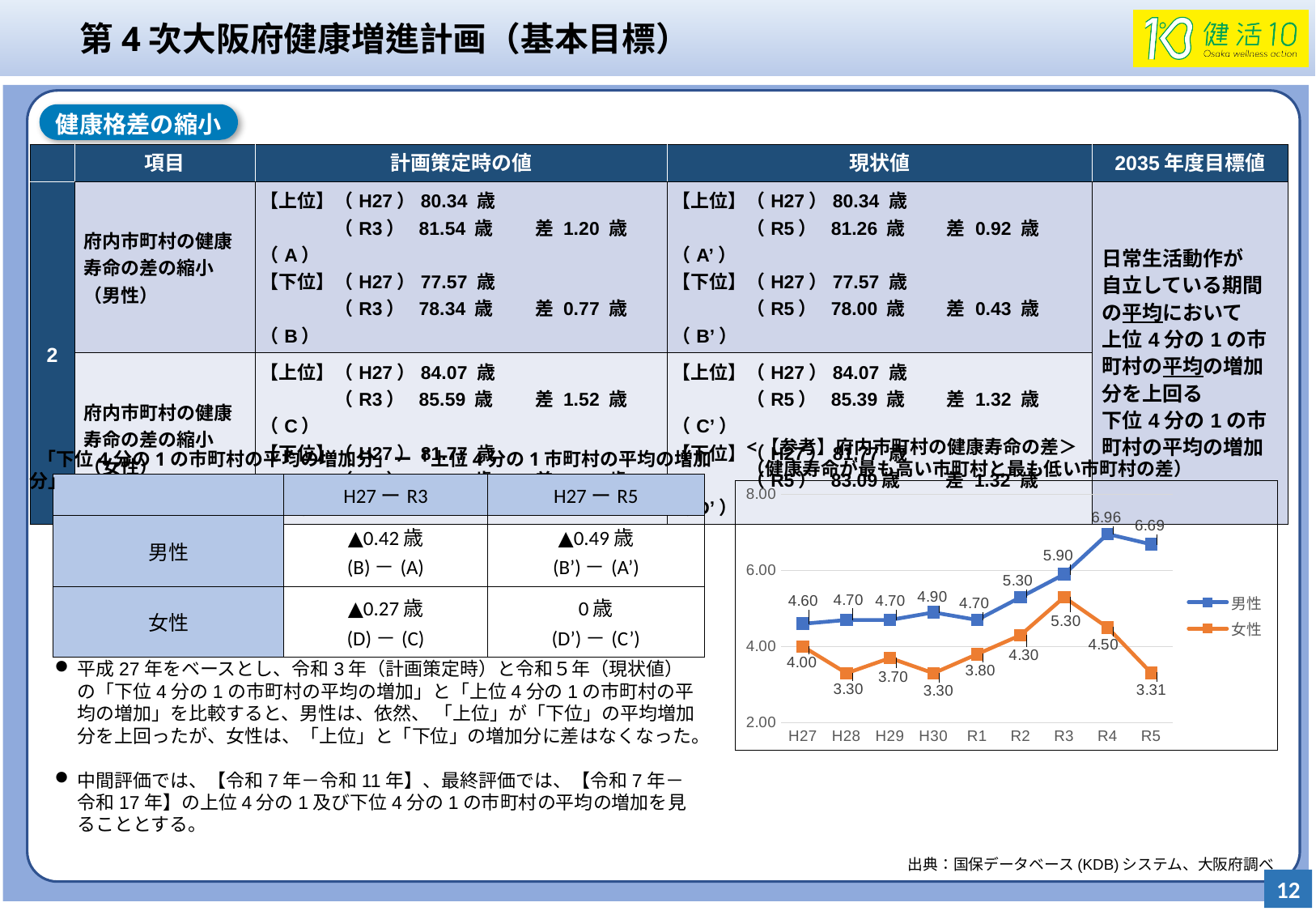
In the line chart, what is the value for 男性 at R4? 6.96 Which series in the line chart is drawn in orange? 女性 In the line chart, at which x-axis point is the 男性 series highest? R4 In the line chart, what is the value for 女性 at R5? 3.31 In the line chart, what is the value for 男性 at H27? 4.60 What kind of chart is shown on the slide? line chart How many series does the legend of the line chart list? 2 In the line chart, what is the difference between the 男性 and 女性 values at R5? 3.38 In the line chart, at which x-axis point is the 女性 series highest? R3 In the line chart, which series has the larger value at R3, 男性 or 女性? 男性 How many points along the x axis does the line chart have? 9 In the line chart, is the value for 女性 at R2 greater or less than 4.00? greater